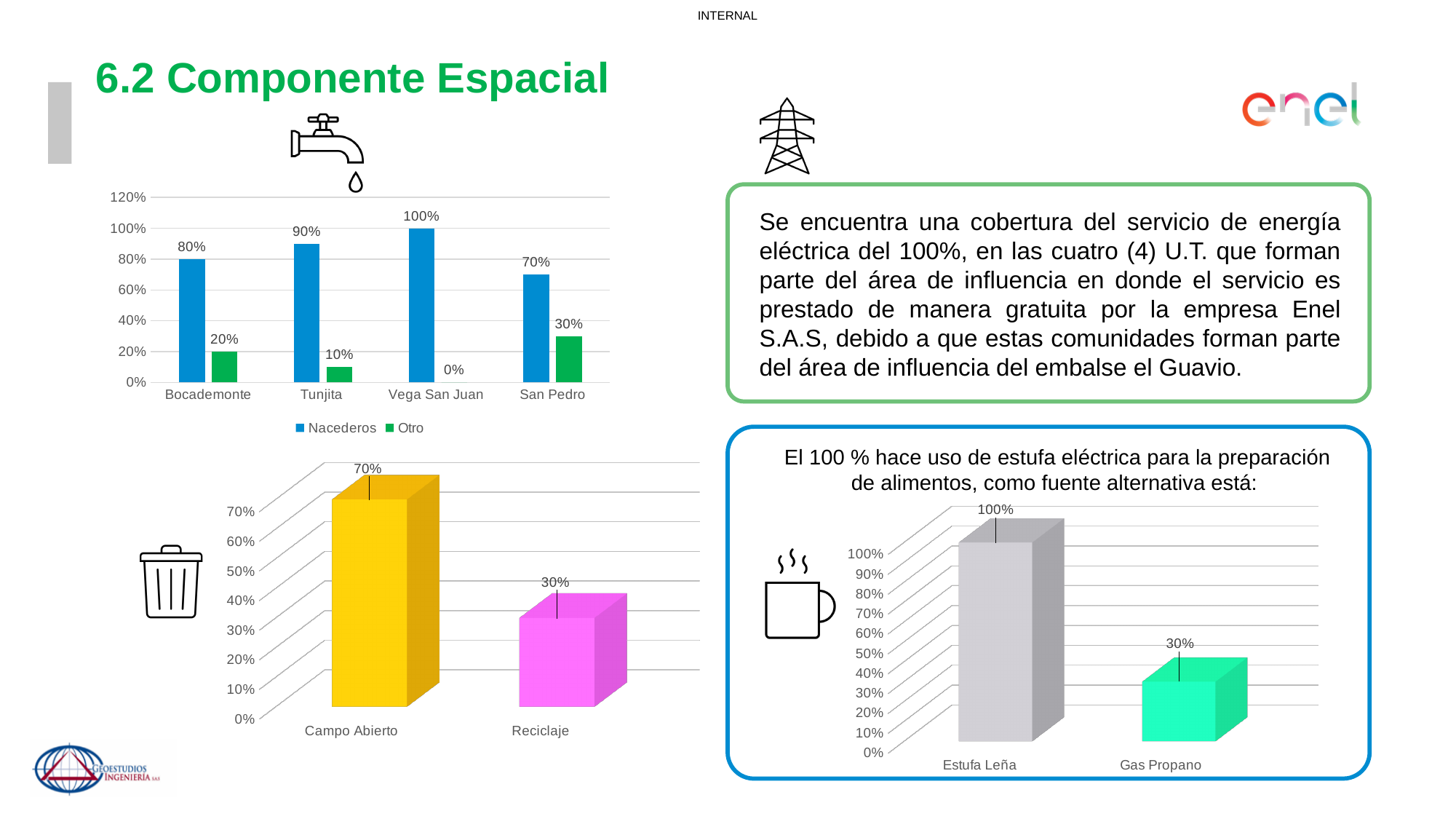
In the top-left chart, what is the difference between the Nacederos and Otro values for Bocademonte? 60% In the bottom-left chart, what is the value for Campo Abierto? 70% In the top-left chart, which category has the lowest Otro value? Vega San Juan In the top-left chart, what is the Nacederos value for Tunjita? 90% In the bottom-right chart, what is the value for Gas Propano? 30% In the bottom-left chart, what is the difference between Campo Abierto and Reciclaje? 40% In the top-left chart, how many categories are shown on the x axis? 4 In the bottom-right chart, which category is larger, Estufa Leña or Gas Propano? Estufa Leña What kind of chart is the bottom-right chart? Bar chart In the top-left chart, what is the Otro value for San Pedro? 30% In the top-left chart, how many series does the legend list? 2 In the top-left chart, which category has the highest Nacederos value? Vega San Juan